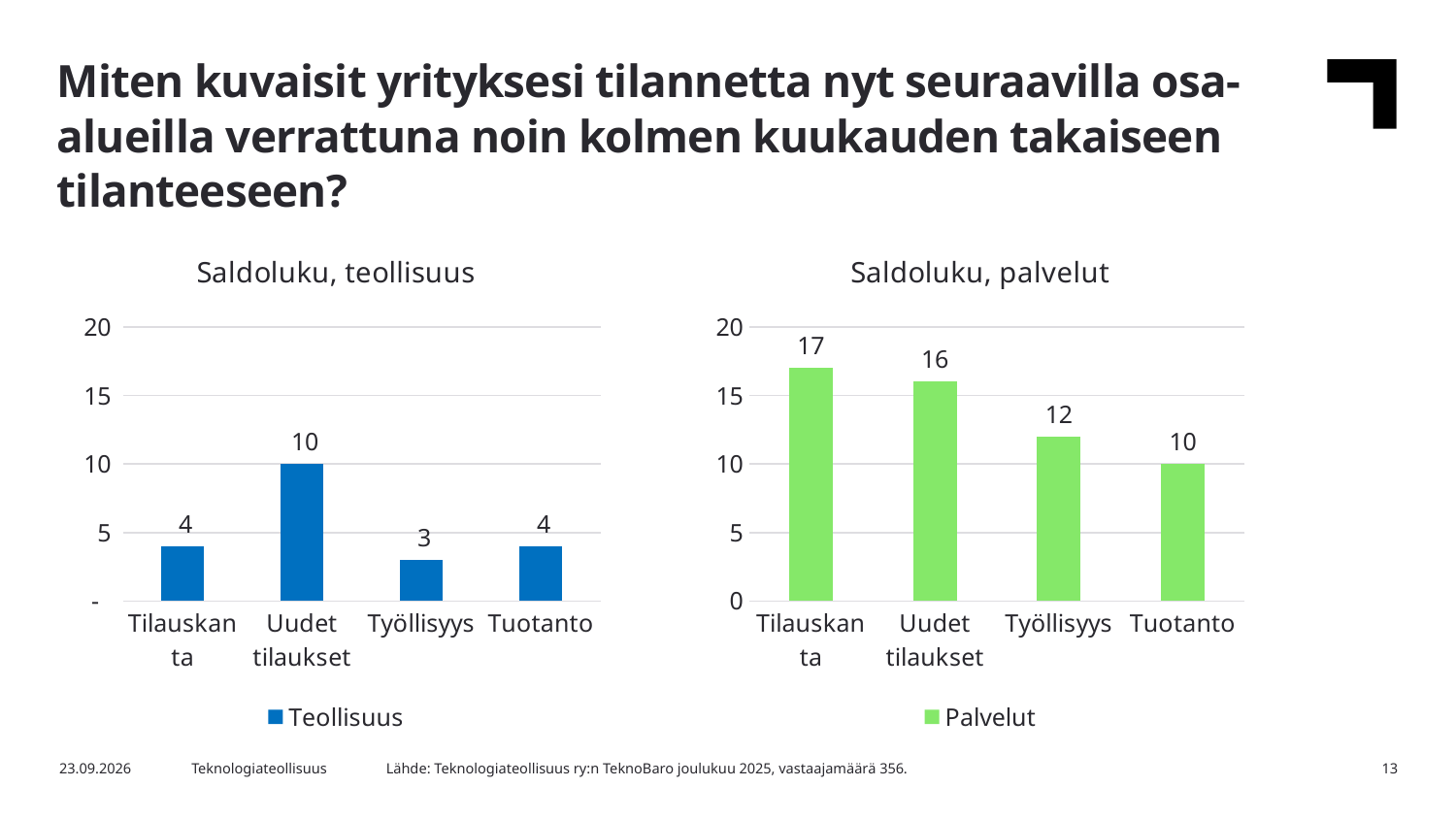
What series does the legend of the 'Saldoluku, teollisuus' chart list? Teollisuus In the 'Saldoluku, palvelut' chart, is the value for Uudet tilaukset greater or less than 15? greater In the 'Saldoluku, palvelut' chart, what is the value for Tilauskanta? 17 In the 'Saldoluku, teollisuus' chart, which category has the lowest value? Työllisyys In the 'Saldoluku, palvelut' chart, which category has the highest value? Tilauskanta In the 'Saldoluku, palvelut' chart, what is the difference between Tilauskanta and Tuotanto? 7 What kind of chart is 'Saldoluku, palvelut'? Bar chart In the 'Saldoluku, palvelut' chart, which category has the lowest value? Tuotanto How many categories are shown in the 'Saldoluku, teollisuus' chart? 4 In the 'Saldoluku, teollisuus' chart, what is the difference between Uudet tilaukset and Työllisyys? 7 Which is larger: Työllisyys in the 'Saldoluku, teollisuus' chart or Työllisyys in the 'Saldoluku, palvelut' chart? Saldoluku, palvelut In the 'Saldoluku, teollisuus' chart, what is the value for Uudet tilaukset? 10